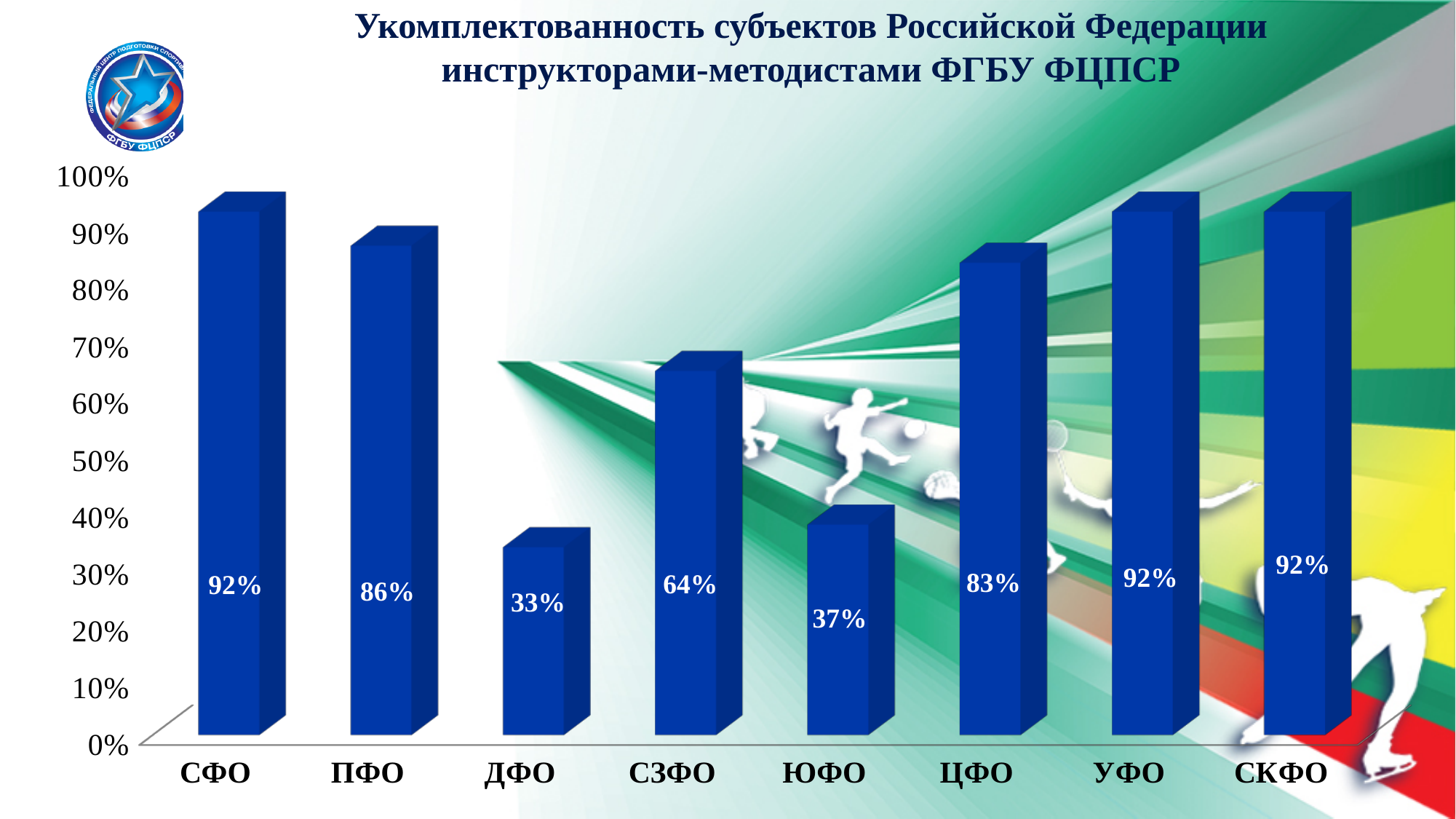
What is the difference between the values for СФО and ЦФО? 9% What is the value for ДФО? 33% Is the value for ЦФО greater or less than 80%? greater Which category has the lowest value? ДФО How many categories are shown on the x axis? 8 What is the title of the chart? Укомплектованность субъектов Российской Федерации инструкторами-методистами ФГБУ ФЦПСР Which is larger, the value for СЗФО or the value for ЮФО? СЗФО What is the value for ПФО? 86% What is the difference between the values for ПФО and ЮФО? 49% What is the value for СЗФО? 64% What is the value for ЦФО? 83% What kind of chart is shown on the slide? bar chart